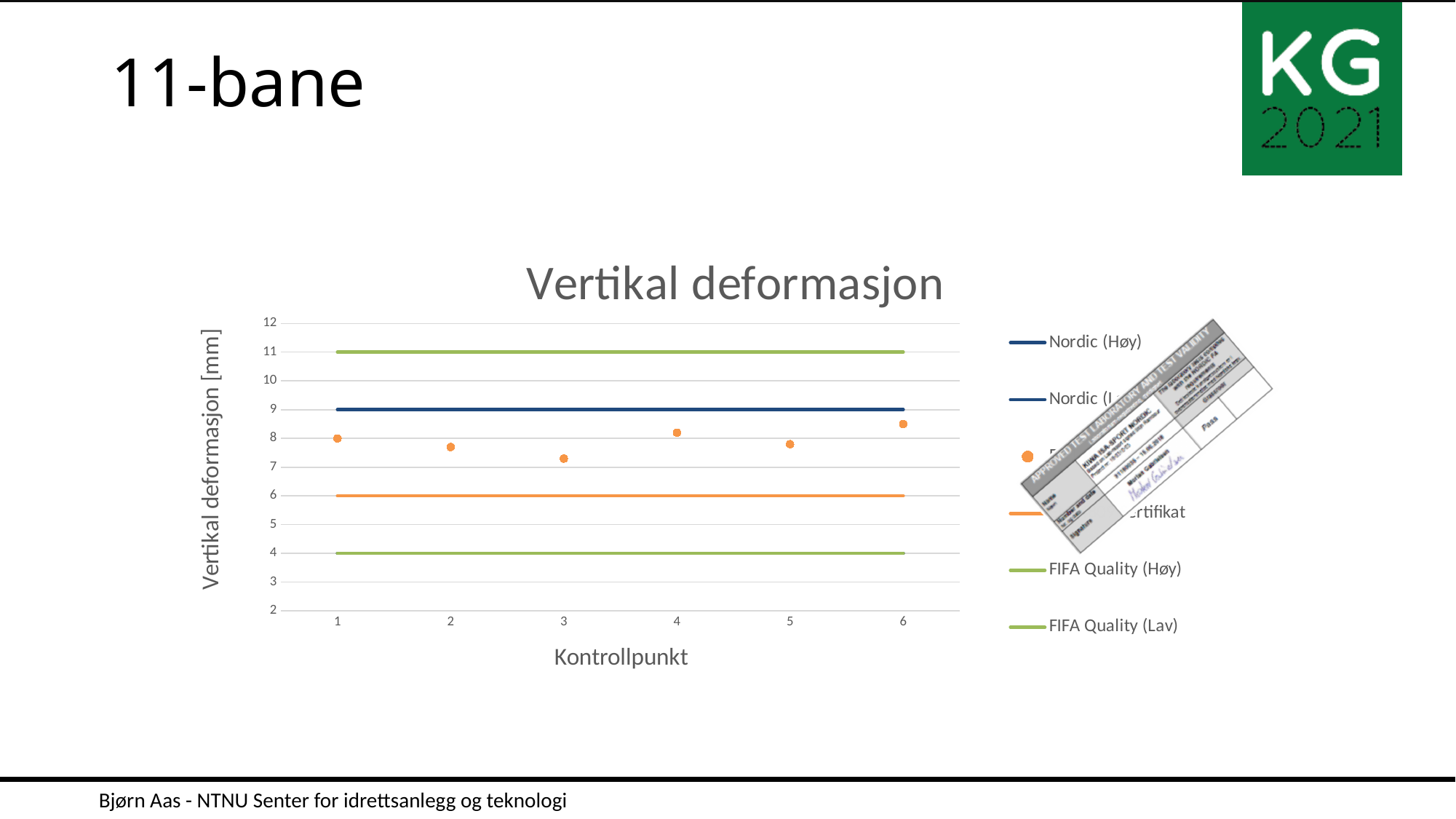
At what value does the FIFA Quality (Høy) line lie? 11 How many kontrollpunkt (control points) are shown on the x axis? 6 Is the measured value (orange dot) at kontrollpunkt 3 greater or less than 8? less Which has the larger measured value (orange dot): kontrollpunkt 2 or kontrollpunkt 3? Kontrollpunkt 2 What is the difference between the FIFA Quality (Høy) line and the FIFA Quality (Lav) line? 7 At which kontrollpunkt is the measured value (orange dot) lowest? 3 At which kontrollpunkt is the measured value (orange dot) highest? 6 At what value does the Nordic (Høy) line lie? 9 What is the title of the chart? Vertikal deformasjon At what value does the FIFA Quality (Lav) line lie? 4 Is the measured value (orange dot) at kontrollpunkt 6 greater or less than 8? greater What is the label of the x axis? Kontrollpunkt